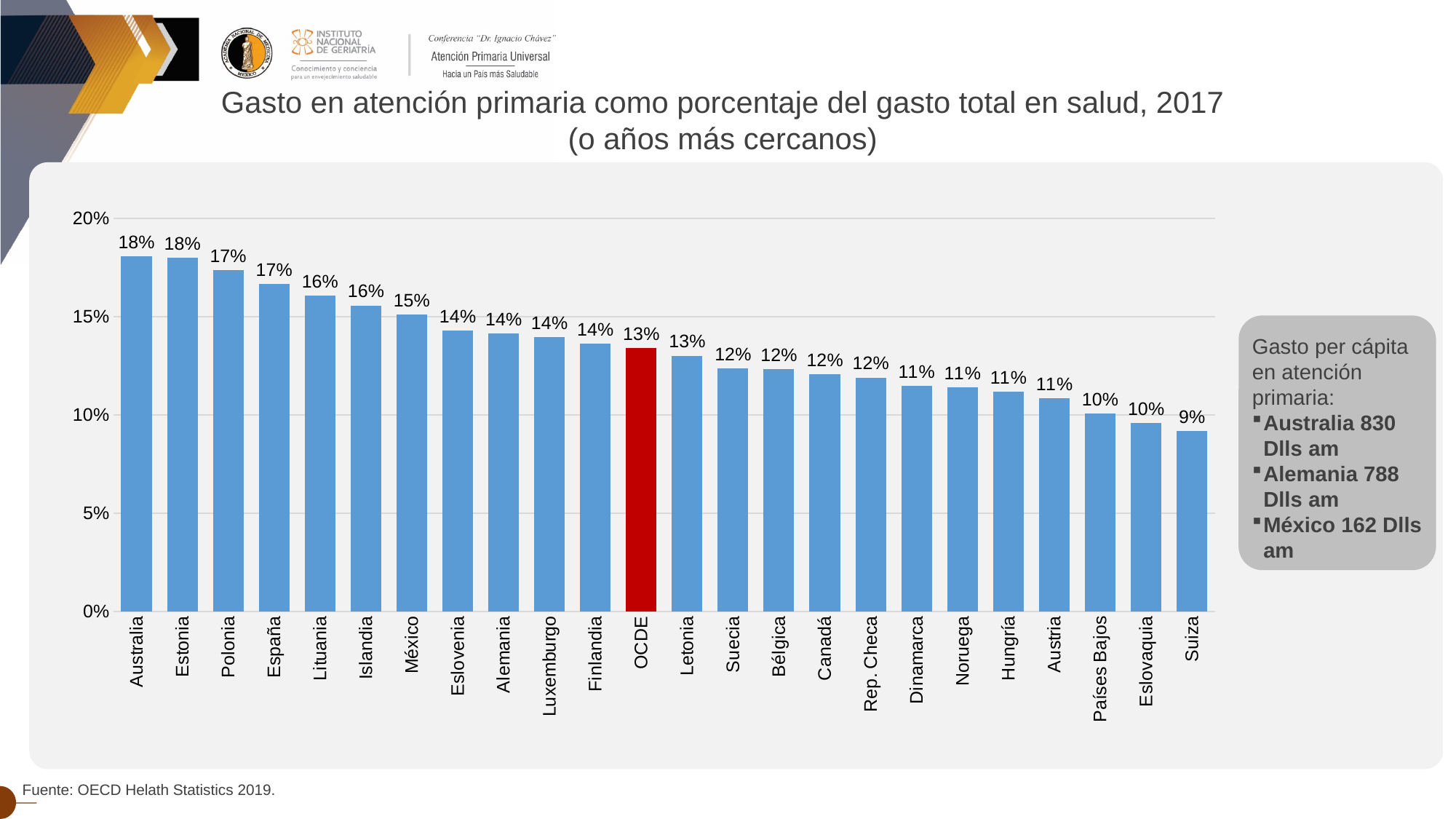
What is the difference between the values for México and OCDE? 2 percentage points Do the values rise or fall moving from left to right along the x axis? Fall What type of chart is shown on the slide? Bar chart What is the value shown for OCDE? 13% Which has a larger value, México or OCDE? México What is the value shown for Alemania? 14% What is the value shown for Suiza? 9% What is the difference between the values for Australia and Suiza? 9 percentage points What is the value shown for México? 15% Which bar in the chart is coloured red instead of blue? OCDE How many categories are plotted in the chart? 24 Which category has the lowest value in the chart? Suiza